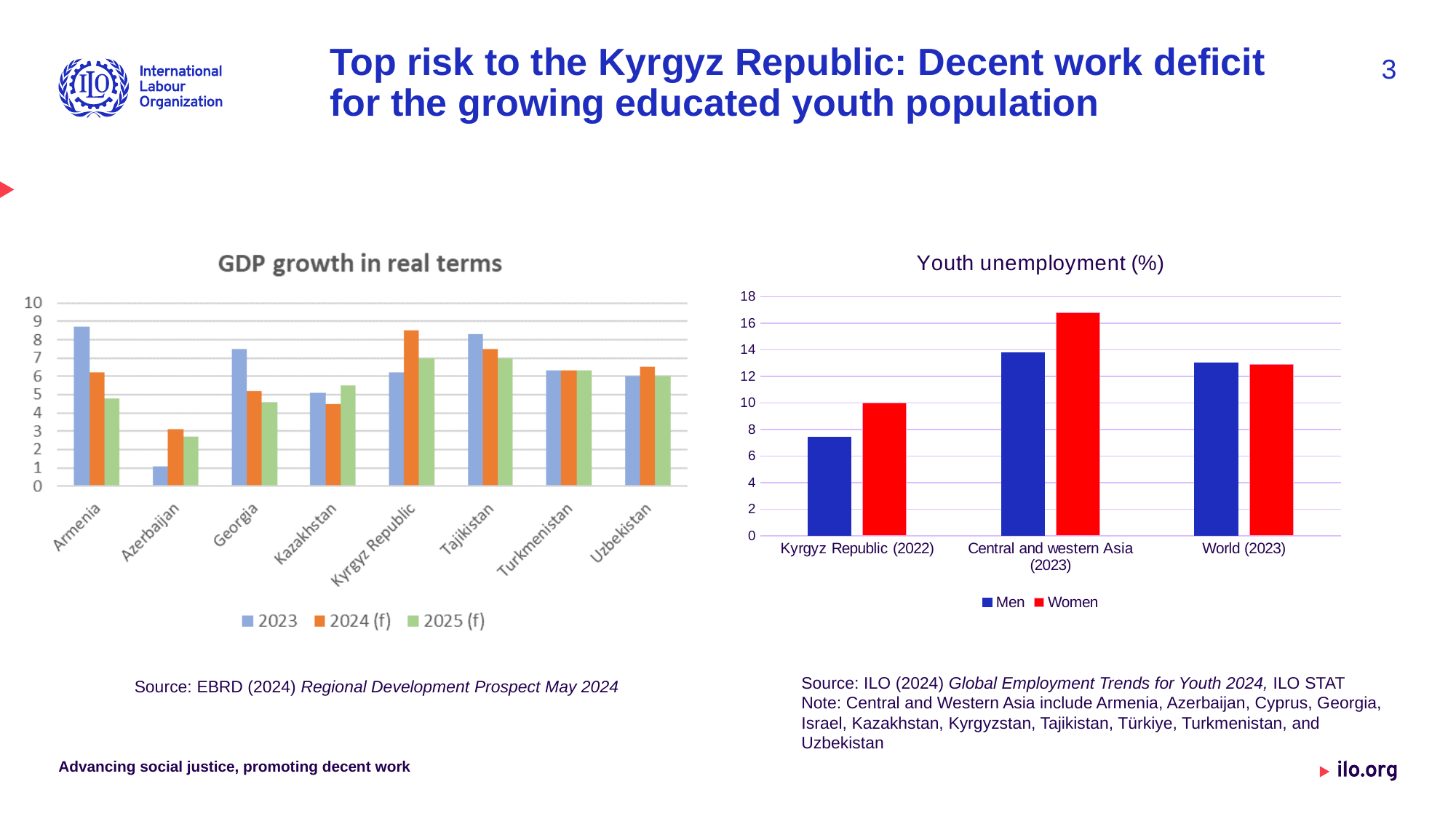
In the 'GDP growth in real terms' chart, is the 2023 value for Azerbaijan greater or less than 2? less In the 'Youth unemployment (%)' chart, which is larger for the Kyrgyz Republic (2022): Men or Women? Women In the 'GDP growth in real terms' chart, which country has the lowest 2023 value? Azerbaijan In the 'Youth unemployment (%)' chart, is the value for Women in Central and western Asia (2023) greater or less than 16? greater In the 'GDP growth in real terms' chart, is the 2023 value for Armenia greater or less than 8? greater What kind of chart is the 'Youth unemployment (%)' chart? bar chart What kind of chart is the 'GDP growth in real terms' chart? bar chart How many series does the legend of the 'GDP growth in real terms' chart list? 3 In the 'GDP growth in real terms' chart, which is larger for the Kyrgyz Republic: the 2023 value or the 2024 (f) value? 2024 (f) How many countries are shown on the x axis of the 'GDP growth in real terms' chart? 8 How many series does the legend of the 'Youth unemployment (%)' chart list? 2 In the 'Youth unemployment (%)' chart, which colour represents Men in the legend? blue